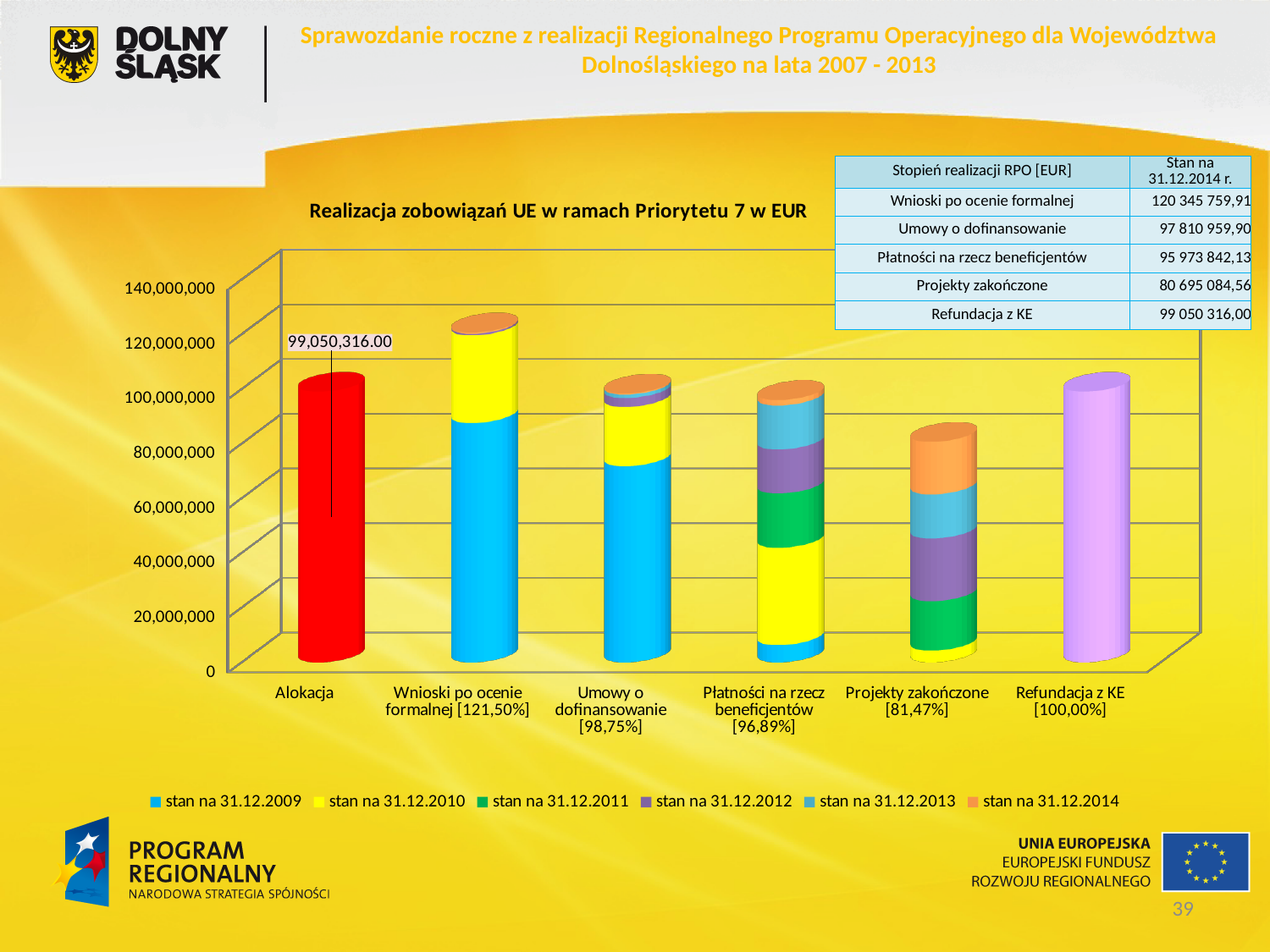
How many categories are shown on the x axis of the chart? 6 How many series does the chart legend list? 6 What value is labelled on the Alokacja bar? 99,050,316.00 Is the total value for Projekty zakończone greater or less than 100,000,000? less Which category has the shortest bar in the chart? Projekty zakończone [81,47%] What is the title of the chart? Realizacja zobowiązań UE w ramach Priorytetu 7 w EUR What kind of chart is shown on the slide? bar chart What percentage is shown in brackets in the x-axis label for Refundacja z KE? 100,00% Which category has the tallest bar in the chart? Wnioski po ocenie formalnej [121,50%] Is the total value for Umowy o dofinansowanie greater or less than 80,000,000? greater Is the total value for Wnioski po ocenie formalnej greater or less than 100,000,000? greater Which bar is taller: Alokacja or Projekty zakończone? Alokacja